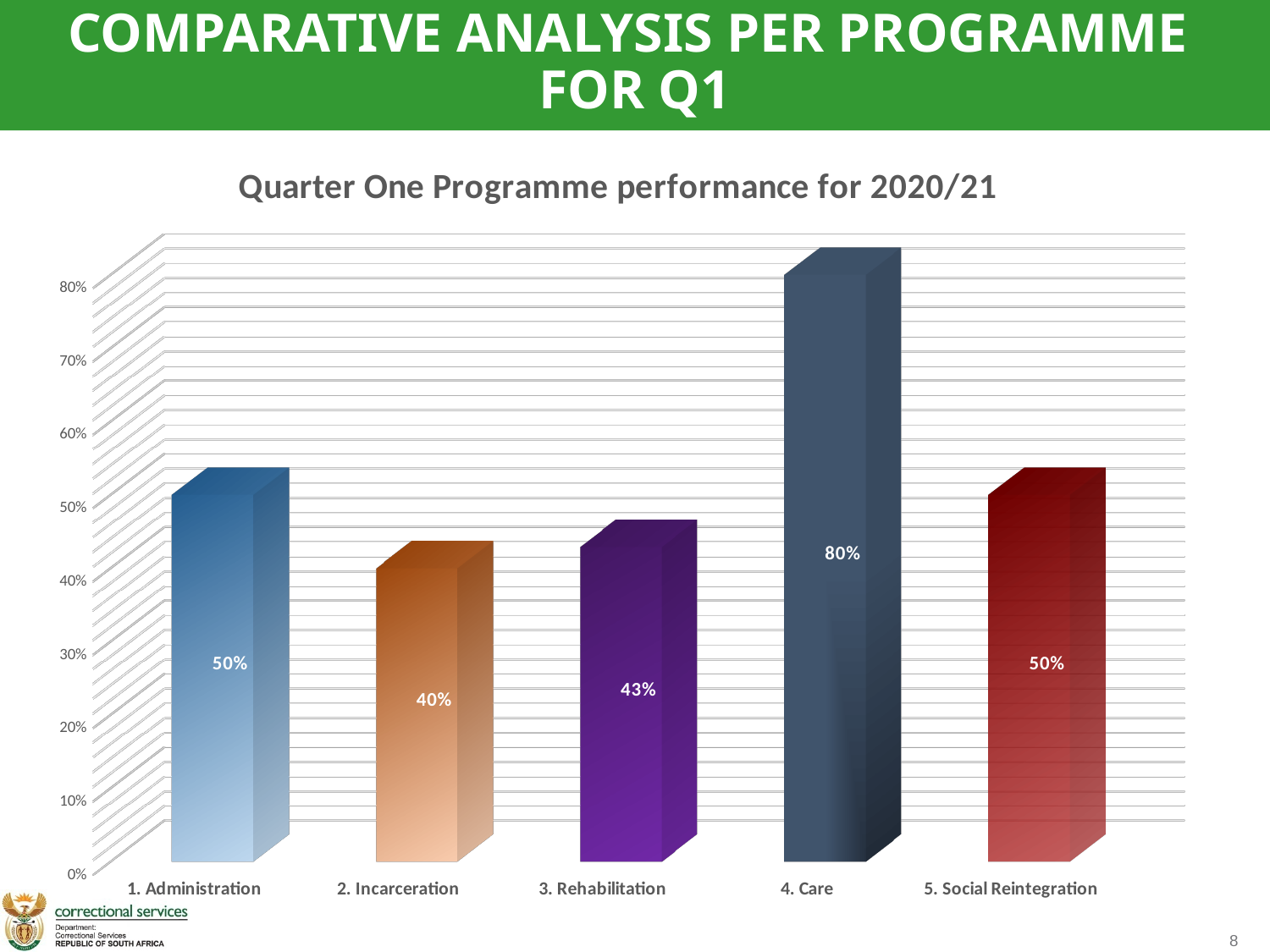
Which is larger, the value for 3. Rehabilitation or the value for 5. Social Reintegration? 5. Social Reintegration What is the value for 4. Care? 80% What kind of chart is shown on the slide? Bar chart What is the title of the chart? Quarter One Programme performance for 2020/21 How many programmes are shown on the chart? 5 What is the value for 3. Rehabilitation? 43% What is the value for 2. Incarceration? 40% What is the difference between the values for 4. Care and 2. Incarceration? 40% What is the value for 1. Administration? 50% Which programme has the lowest value? 2. Incarceration Which programme has the highest value? 4. Care What is the difference between the values for 1. Administration and 3. Rehabilitation? 7%